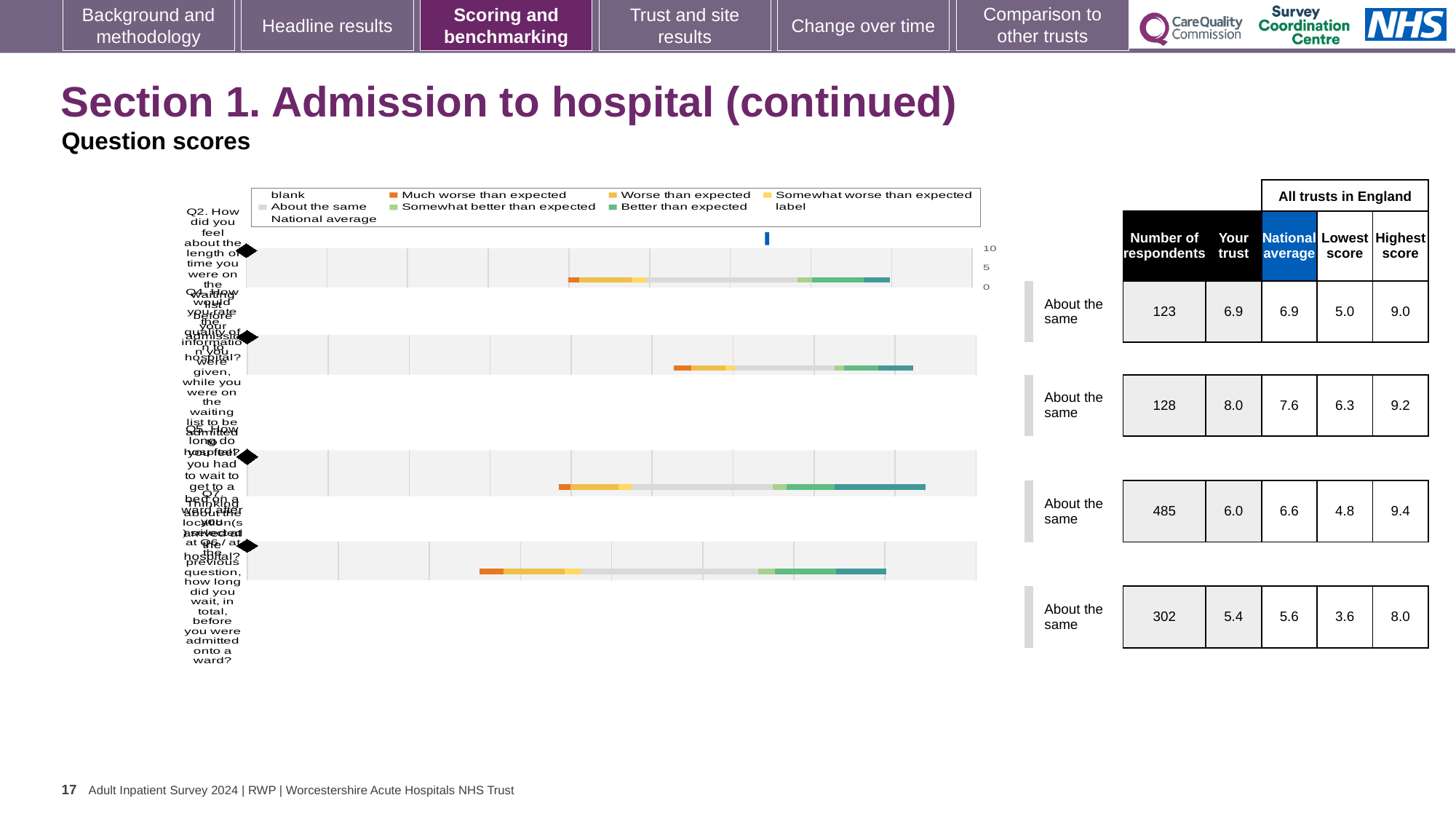
In the table next to the chart, what is the 'Lowest score' in the row with 302 respondents? 3.6 Which colour does the legend use for 'Much worse than expected'? Orange What kind of chart is shown on the slide? Bar chart In the table next to the chart, what is the 'Highest score' in the row with 485 respondents? 9.4 How many horizontal bars (question rows) does the chart contain? 4 What is the maximum value shown on the chart's numeric axis? 10 In the table next to the chart, what is the 'Your trust' score in the first row (123 respondents)? 6.9 In the table next to the chart, which row has the highest number of respondents? 485 What benchmark label is shown for every question row on the slide? About the same In the table next to the chart, is the 'Your trust' score (8.0) in the row with 128 respondents larger or smaller than the national average (7.6)? Larger In the table next to the chart, what is the difference between the 'Your trust' score and the national average in the row with 485 respondents? 0.6